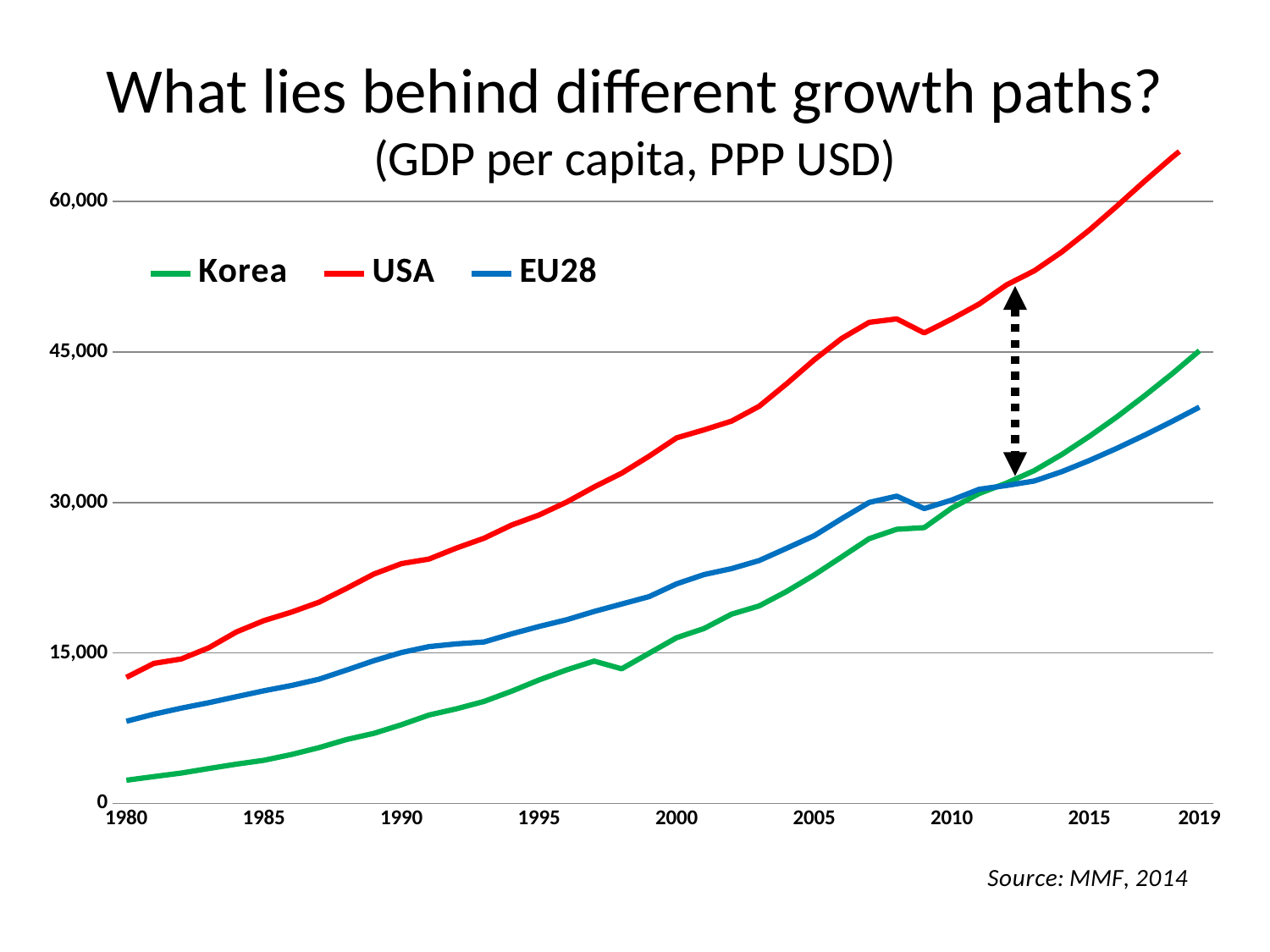
Is the value for USA in 2019 greater or less than 60,000? greater Is the value for EU28 in 2019 greater or less than 45,000? less Which series has the highest GDP per capita in 2019? USA Is the value for USA in 1980 greater or less than 15,000? less How many series does the legend list? 3 What kind of chart is shown on the slide? Line chart Does the Korea line rise or fall from 1980 to 2019? rise In 2019, which is larger, the value for Korea or the value for EU28? Korea What colour is the line for Korea? Green In 1980, which is larger, the value for Korea or the value for EU28? EU28 Which series has the lowest GDP per capita in 1980? Korea